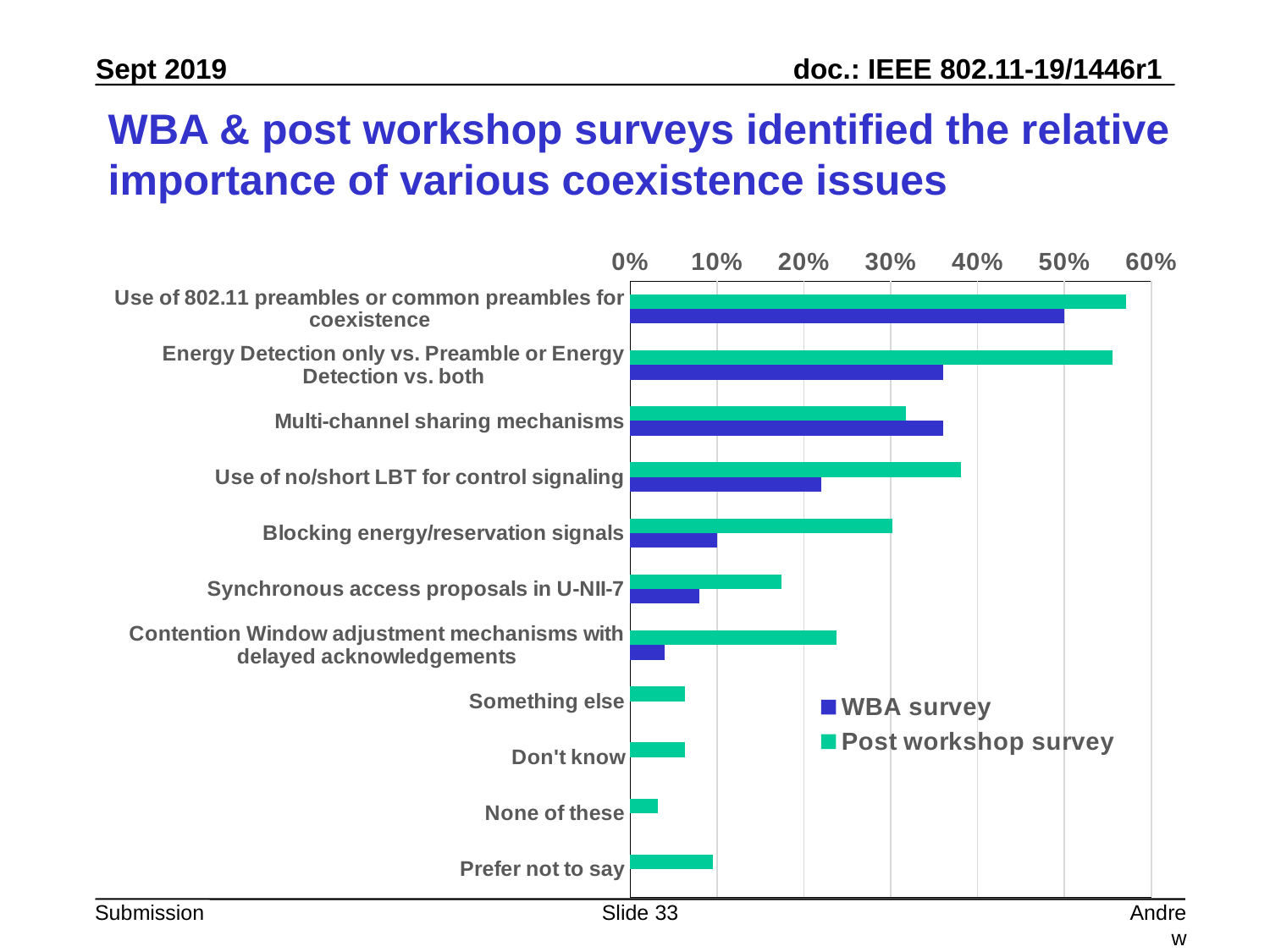
Which category has the highest value for the WBA survey series? Use of 802.11 preambles or common preambles for coexistence Is the Post workshop survey value for Use of no/short LBT for control signaling greater or less than 30%? greater Is the WBA survey value for Synchronous access proposals in U-NII-7 greater or less than 10%? less Which category has the lowest value for the Post workshop survey series? None of these For Multi-channel sharing mechanisms, which series has the larger value, WBA survey or Post workshop survey? WBA survey How many series does the legend list? 2 Is the WBA survey value for Energy Detection only vs. Preamble or Energy Detection vs. both greater or less than 30%? greater For Blocking energy/reservation signals, which series has the larger value, WBA survey or Post workshop survey? Post workshop survey What colour represents the WBA survey series in the chart? Blue What kind of chart is shown on the slide? Bar chart How many categories are plotted on the chart? 11